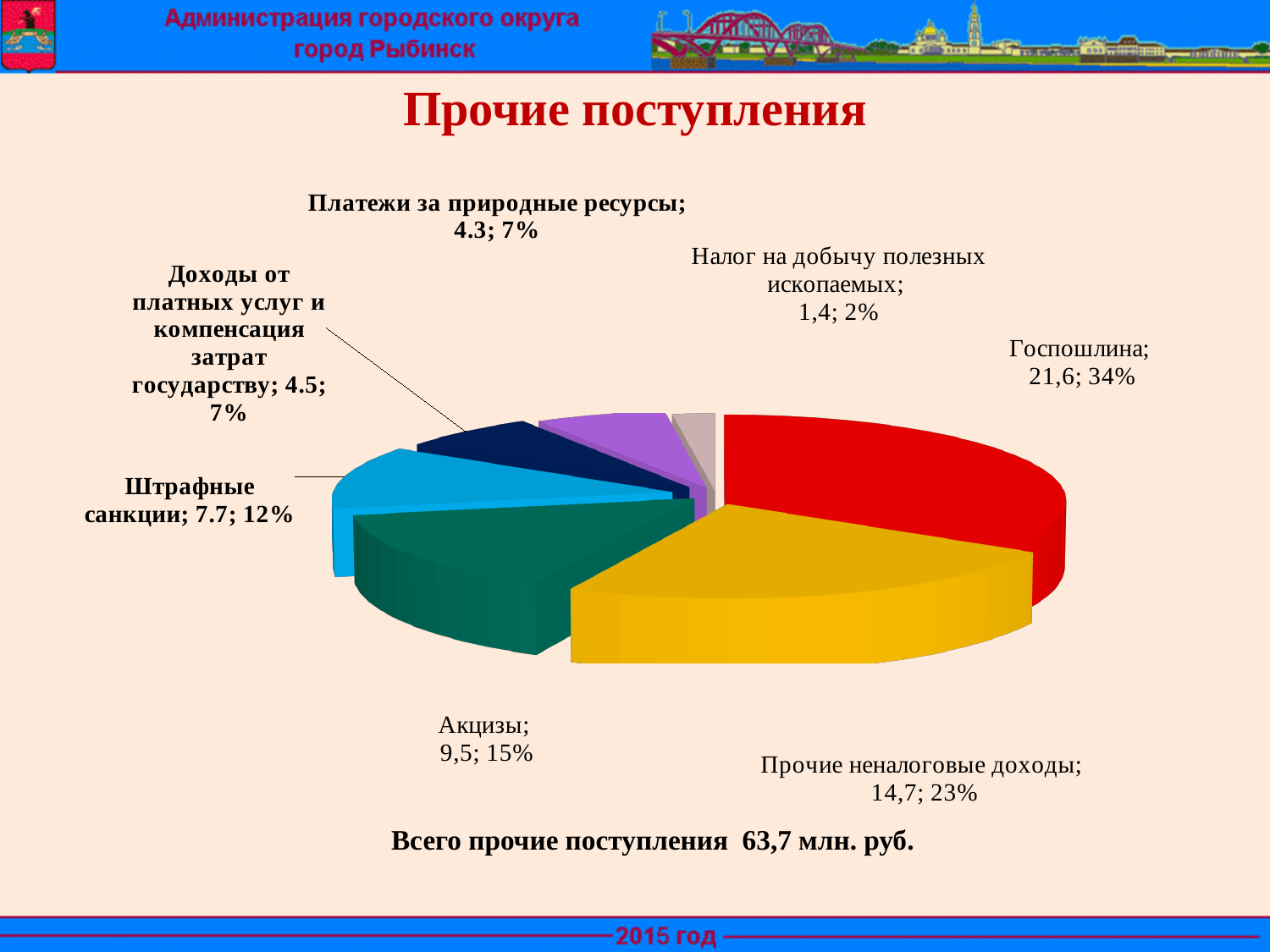
What is the difference between the values for Госпошлина and Прочие неналоговые доходы? 6,9 How many slices does the pie chart have? 7 What is the value shown for Штрафные санкции? 7.7 What share of the pie does Акцизы represent? 15% What is the value shown for Госпошлина? 21,6 Which category has the smallest slice of the pie? Налог на добычу полезных ископаемых Which is larger, the value for Акцизы or the value for Штрафные санкции? Акцизы What is the title of the chart on the slide? Прочие поступления Which category has the largest slice of the pie? Госпошлина What is the total of all other receipts (Всего прочие поступления) stated on the slide? 63,7 млн. руб. What share of the pie does Прочие неналоговые доходы represent? 23% What kind of chart is shown on the slide? pie chart